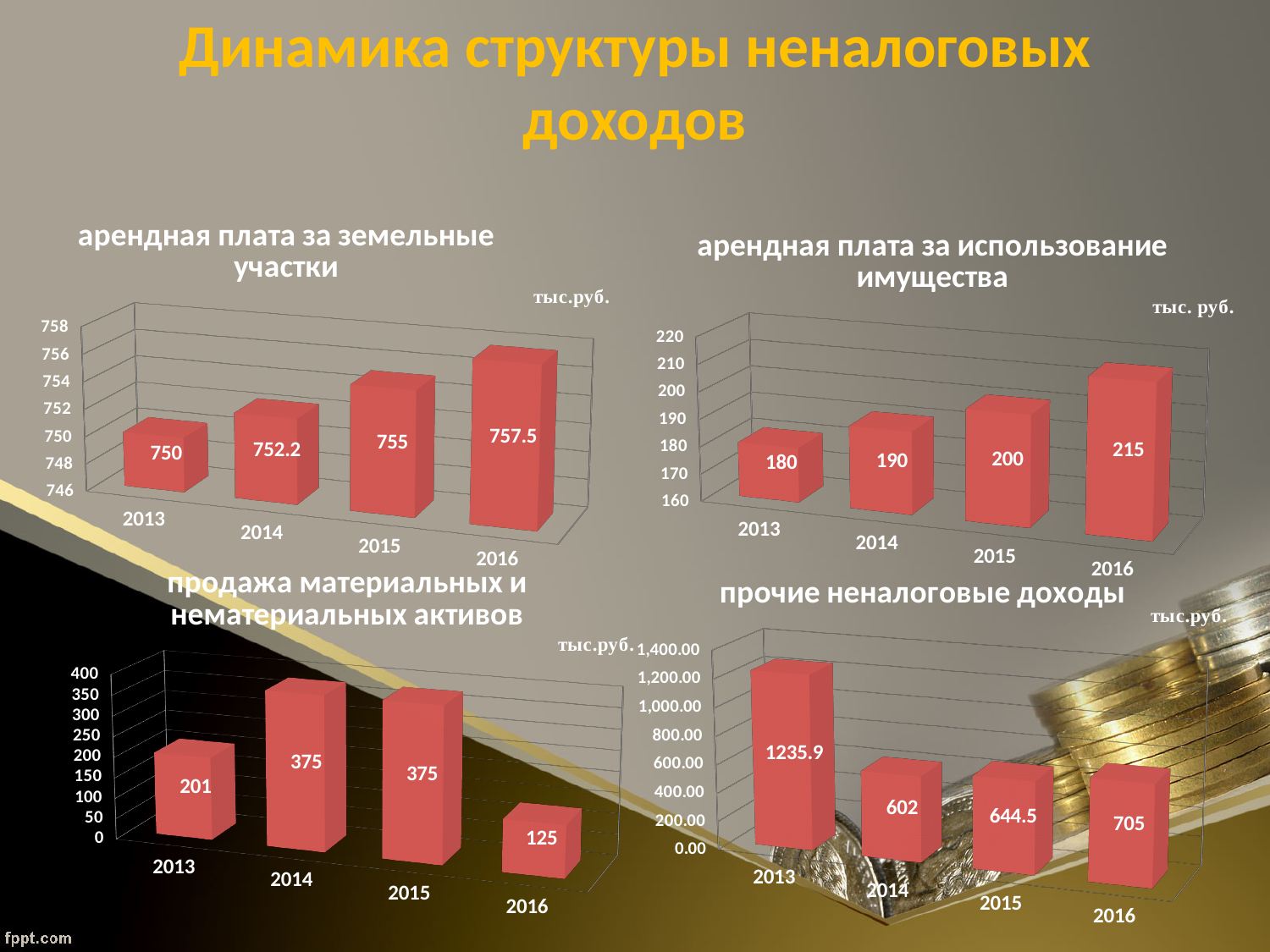
In the chart titled "продажа материальных и нематериальных активов", which year has the lowest value? 2016 In the chart titled "прочие неналоговые доходы", what is the difference between the 2016 and 2015 values? 60.5 In the chart titled "прочие неналоговые доходы", what is the value for 2013? 1235.9 In the chart titled "арендная плата за использование имущества", do the values rise or fall from 2013 to 2016? rise In the chart titled "арендная плата за земельные участки", what is the difference between the 2016 and 2013 values? 7.5 In the chart titled "арендная плата за использование имущества", what is the difference between the 2015 and 2014 values? 10 In the chart titled "продажа материальных и нематериальных активов", what is the value for 2016? 125 In the chart titled "арендная плата за земельные участки", which year has the highest value? 2016 In the chart titled "арендная плата за земельные участки", what is the value for 2014? 752.2 In the chart titled "продажа материальных и нематериальных активов", which is larger, the value for 2013 or the value for 2014? 2014 In the chart titled "арендная плата за использование имущества", what is the value for 2016? 215 How many charts are on the slide, and what type of chart are they? 4 bar charts